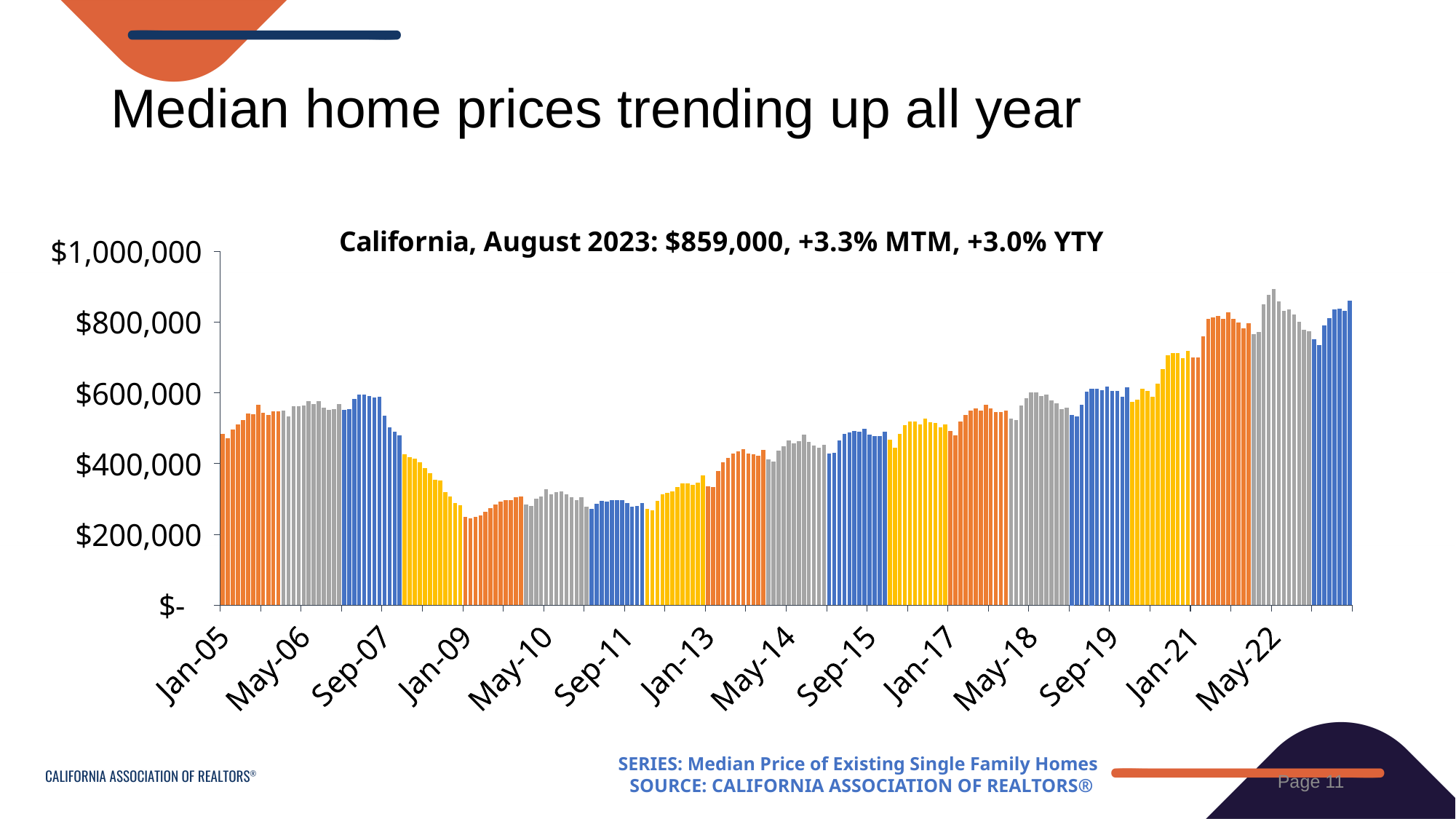
Which is higher, the bar at Sep-07 or the bar at May-22? May-22 How many labels are shown on the x axis? 14 What month-to-month (MTM) change is stated in the chart title for August 2023? +3.3% What kind of chart is shown on the slide? bar chart Is the value for May-22 greater or less than $800,000? greater Is the value for Jan-09 greater or less than $400,000? less What year-to-year (YTY) change is stated in the chart title for August 2023? +3.0% Do the values rise or fall between Sep-07 and Jan-09? fall What is the highest tick value shown on the y axis? $1,000,000 Is the value for Jan-21 greater or less than $600,000? greater What is the California median home price for August 2023 stated in the chart title? $859,000